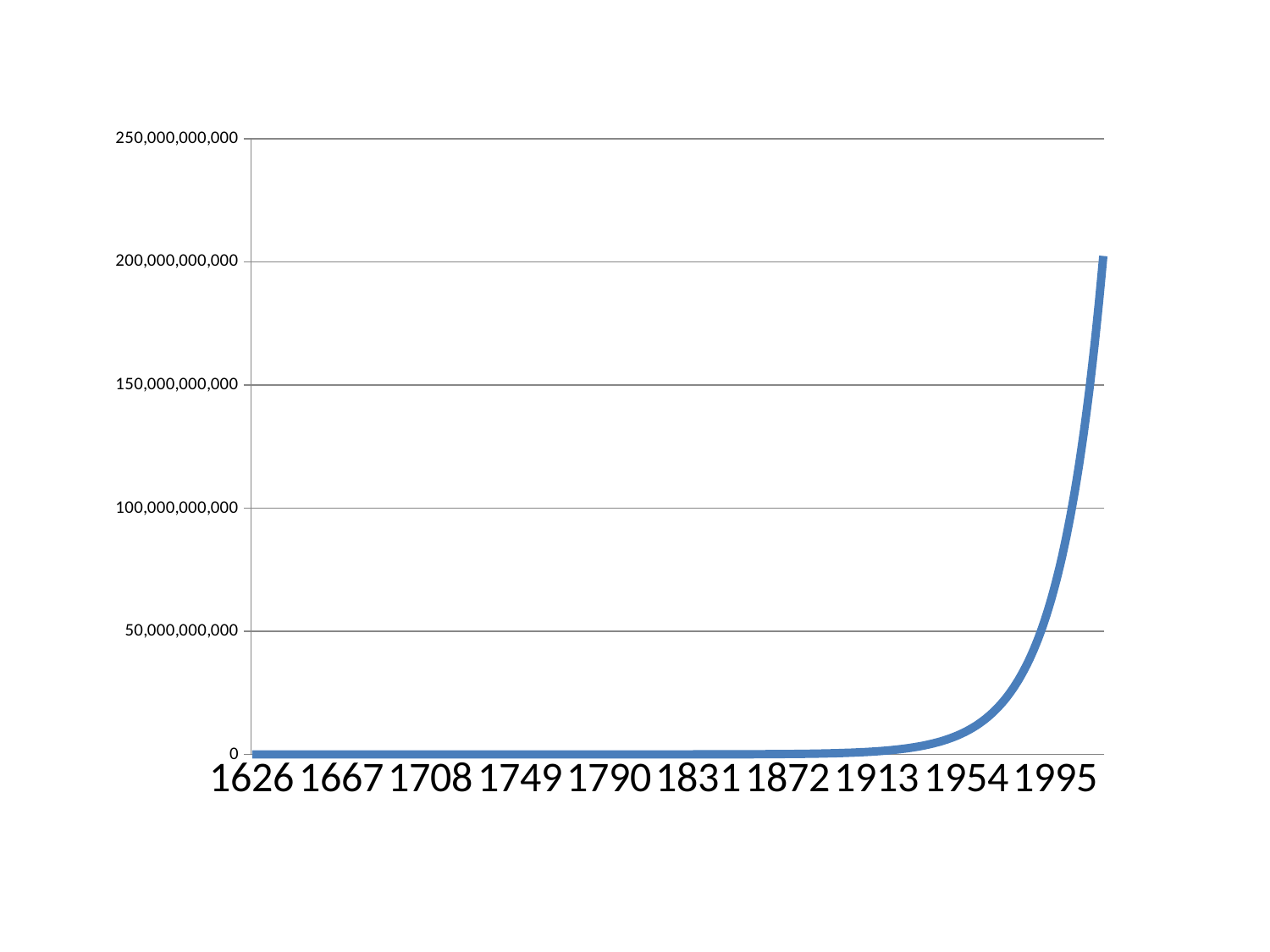
Which has the larger value, 1626 or 1995? 1995 Is the value for 1954 greater or less than 50,000,000,000? less Is the value for 1626 greater or less than 50,000,000,000? less Is the highest point of the line greater or less than 150,000,000,000? greater What is the first year label on the x axis? 1626 What is the highest value shown on the y axis? 250,000,000,000 What kind of chart is shown on the slide? line chart Do the values rise or fall as the years increase along the x axis? rise How many lines are plotted on the chart? 1 How many year labels are shown on the x axis? 10 Which year label on the x axis corresponds to the lowest part of the line? 1626